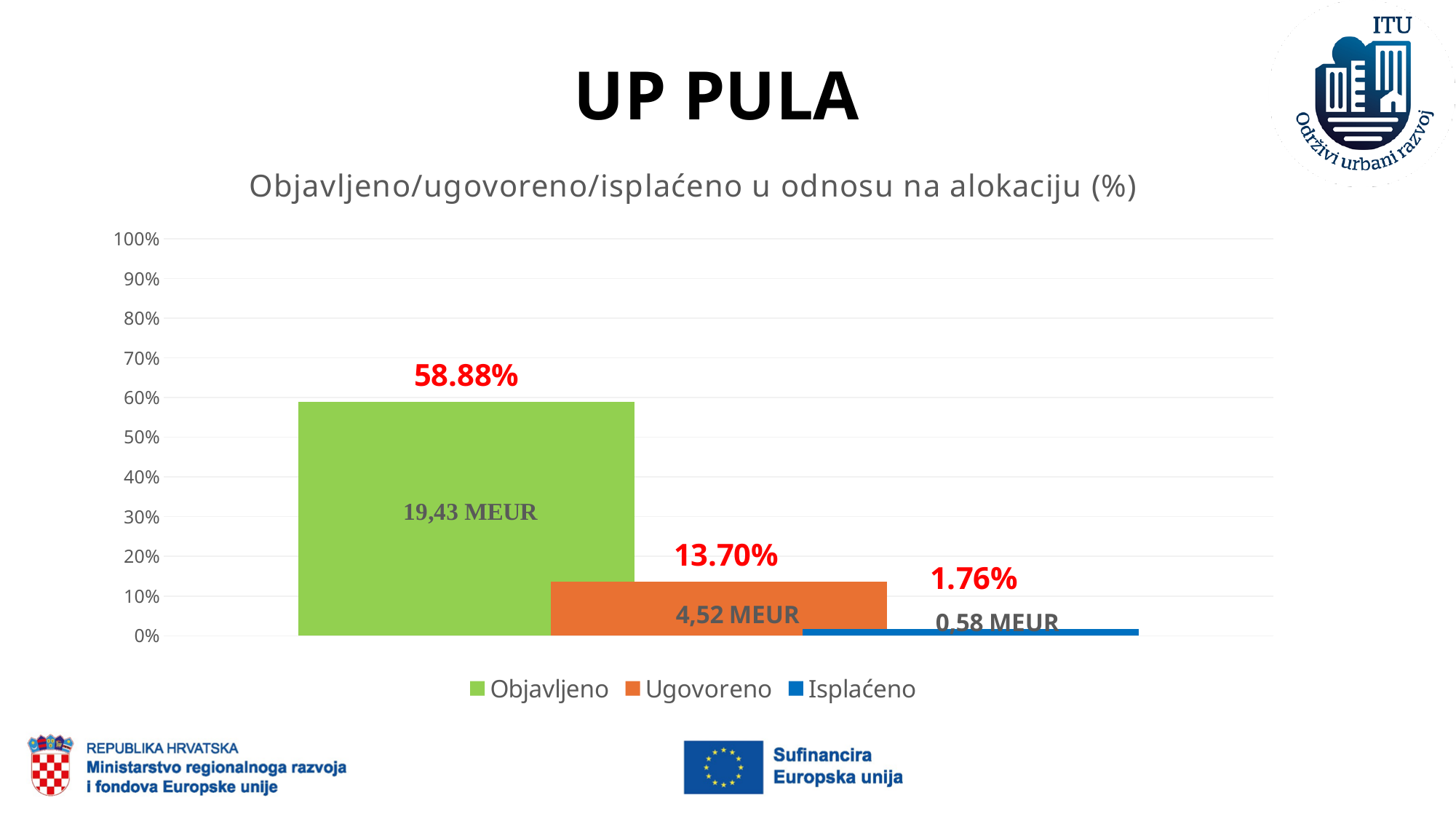
How many series does the legend list? 3 What amount in MEUR is shown on the Objavljeno bar? 19,43 MEUR What amount in MEUR is shown for Ugovoreno? 4,52 MEUR Which series has the highest value? Objavljeno What is the value for Objavljeno? 58.88% What kind of chart is shown? Bar chart Which is larger, Ugovoreno or Isplaćeno? Ugovoreno What is the title of the chart? Objavljeno/ugovoreno/isplaćeno u odnosu na alokaciju (%) What is the value for Isplaćeno? 1.76% What is the difference between the Objavljeno and Ugovoreno percentages? 45.18% Which series has the lowest value? Isplaćeno What is the value for Ugovoreno? 13.70%